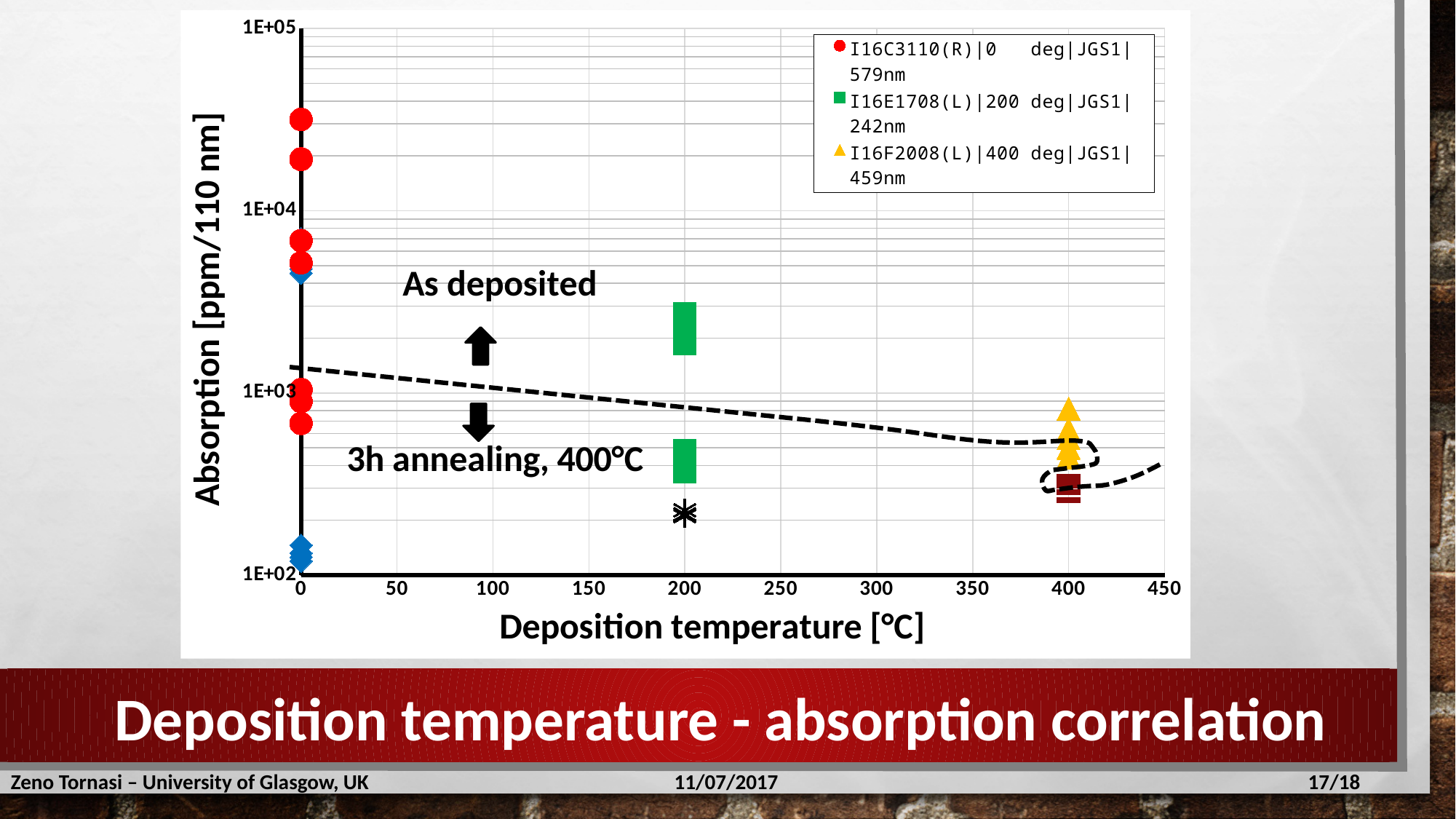
What is the maximum value shown on the x axis? 450 What kind of chart is shown on the slide? scatter chart Which series has the highest absorption values on the chart? I16C3110(R)|0 deg|JGS1|579nm Is the absorption of the blue diamond points near the bottom at 0 °C greater or less than 1E+03? less Is the highest red circle point at 0 °C greater or less than 1E+04? greater What is the label of the y axis? Absorption [ppm/110 nm] What is the label of the x axis? Deposition temperature [°C] How many series does the legend list? 3 Is the absorption of the as-deposited green square points at 200 °C greater or less than 1E+03? greater Which legend series is plotted at a deposition temperature of 400 °C? I16F2008(L)|400 deg|JGS1|459nm Does the dashed trend line rise or fall as deposition temperature increases? fall